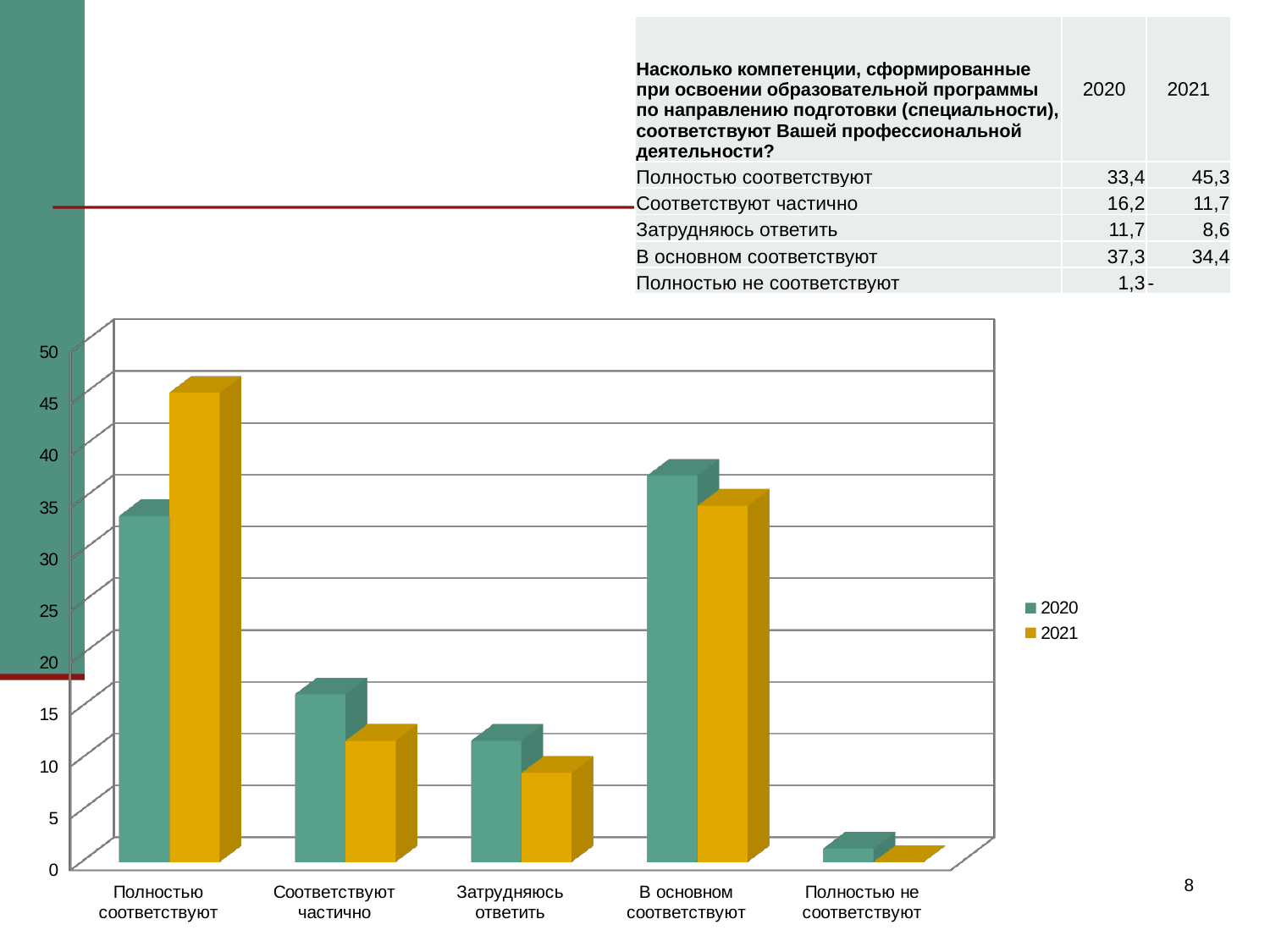
How many categories are shown on the x axis of the chart? 5 Which category has the lowest value for the 2020 series? Полностью не соответствуют Which is larger for "Соответствуют частично": the 2020 value or the 2021 value? 2020 How many series does the chart legend list? 2 What is the 2020 value for "В основном соответствуют"? 37,3 What is the 2021 value for "Полностью соответствуют"? 45,3 Which legend entry is shown in yellow on the chart? 2021 What kind of chart is shown on the slide? bar chart What is the 2020 value for "Затрудняюсь ответить"? 11,7 Is the 2021 value for "Полностью соответствуют" greater or less than 40? greater What is the difference between the 2021 and 2020 values for "Полностью соответствуют"? 11,9 Which category has the highest value for the 2021 series? Полностью соответствуют